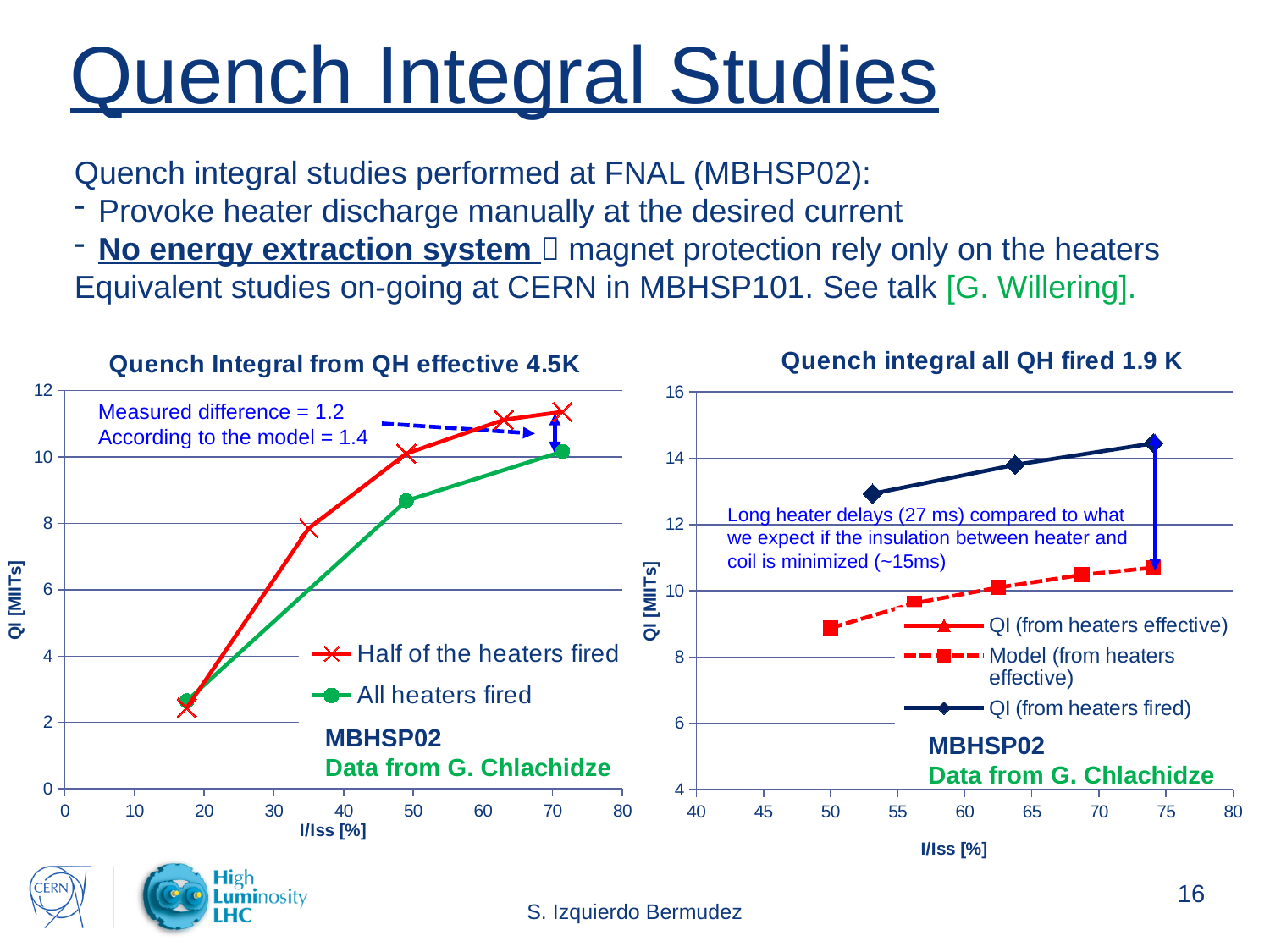
In the 'Quench Integral from QH effective 4.5K' chart, how many data points does the 'All heaters fired' series have? 3 In the 'Quench Integral from QH effective 4.5K' chart, which series reaches the higher QI at the highest I/Iss value? Half of the heaters fired How many series does the legend of the 'Quench Integral from QH effective 4.5K' chart list? 2 In the 'Quench Integral from QH effective 4.5K' chart, how many data points does the 'Half of the heaters fired' series have? 5 In the 'Quench Integral from QH effective 4.5K' chart, is the QI for 'Half of the heaters fired' at its highest I/Iss point greater or less than 10? greater In the 'Quench Integral from QH effective 4.5K' chart, does the QI for 'Half of the heaters fired' rise or fall as I/Iss increases? rise In the 'Quench integral all QH fired 1.9 K' chart, is the 'Model (from heaters effective)' value at I/Iss 50% greater or less than 10? less What kind of chart is the 'Quench Integral from QH effective 4.5K' chart? line chart In the 'Quench integral all QH fired 1.9 K' chart, does the 'QI (from heaters fired)' series rise or fall as I/Iss increases? rise What is the y-axis label of the 'Quench integral all QH fired 1.9 K' chart? QI [MIITs] In the 'Quench integral all QH fired 1.9 K' chart, which series has higher QI values: 'QI (from heaters fired)' or 'Model (from heaters effective)'? QI (from heaters fired) How many series does the legend of the 'Quench integral all QH fired 1.9 K' chart list? 3